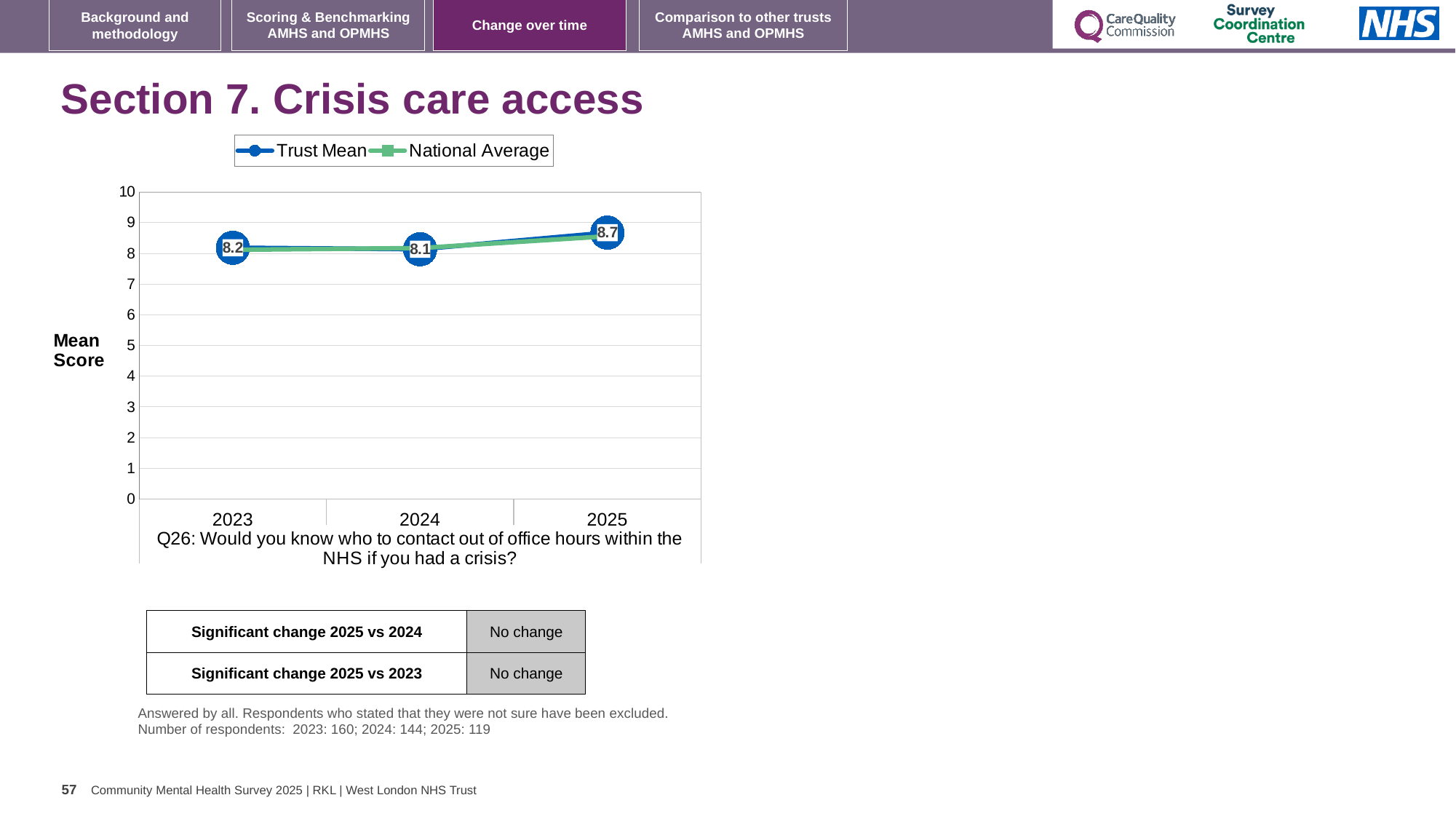
What is the difference between the Trust Mean in 2025 and in 2023? 0.5 What is the Trust Mean score for 2025? 8.7 In which year is the Trust Mean lowest? 2024 What kind of chart is shown on the slide? Line chart Is the National Average value for 2025 greater or less than 8? greater What is the label on the y axis of the chart? Mean Score Which is larger, the Trust Mean in 2025 or in 2024? 2025 How many years are plotted on the x axis? 3 What is the Trust Mean score for 2023? 8.2 In which year is the Trust Mean highest? 2025 What is the Trust Mean score for 2024? 8.1 How many series does the legend list? 2